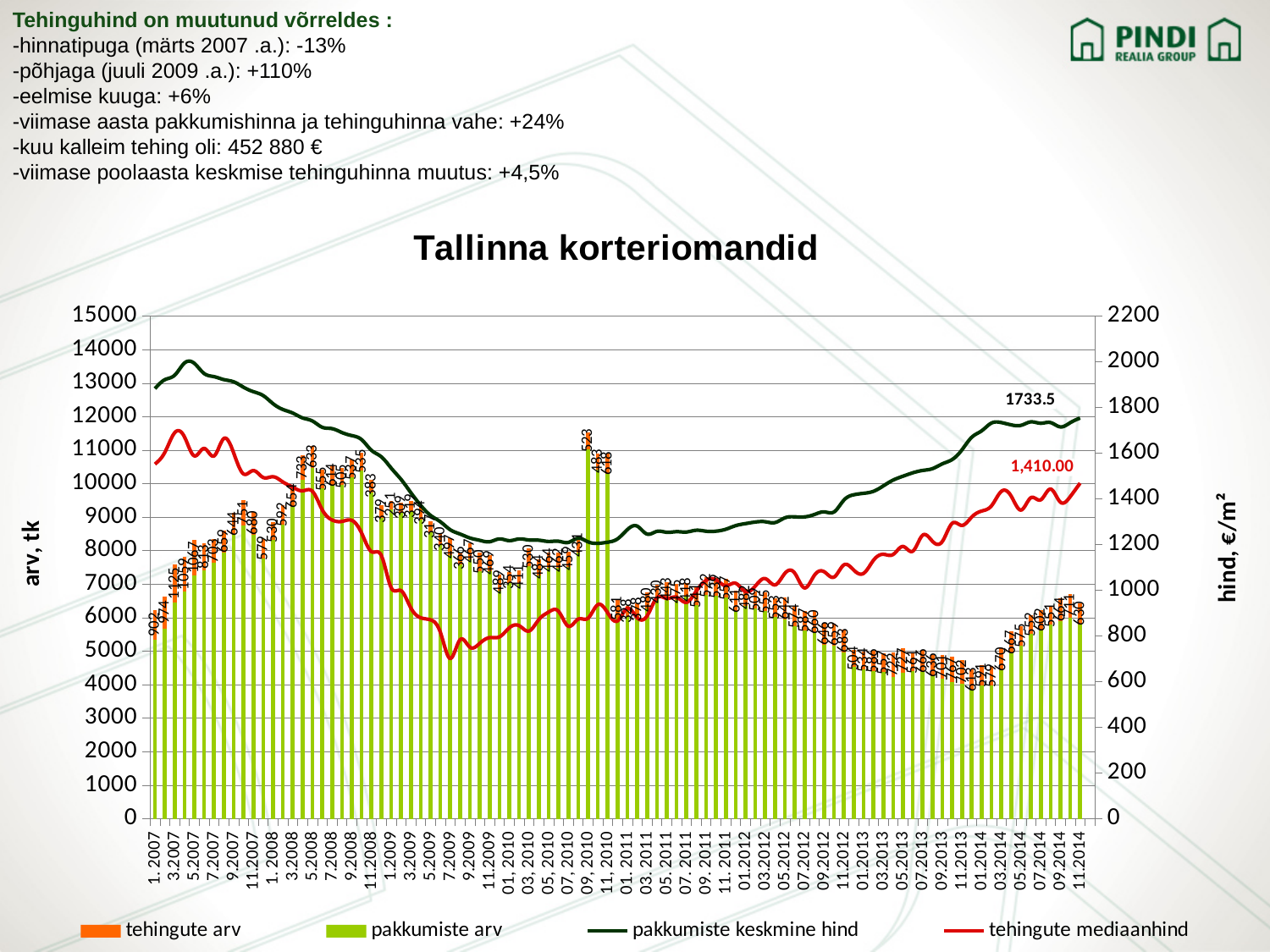
What is the labelled final value of the pakkumiste keskmine hind line? 1733.5 What is the title of the chart? Tallinna korteriomandid Does the pakkumiste keskmine hind line rise or fall between 1.2008 and 1.2010? fall In which month is the pakkumiste arv bar the highest? 09.2010 At the end of the chart, which is higher: pakkumiste keskmine hind or tehingute mediaanhind? pakkumiste keskmine hind What is the labelled final value of the tehingute mediaanhind line? 1,410.00 Is the tehingute mediaanhind value at 7.2009 greater or less than 800? less What is the difference between the labelled final values of pakkumiste keskmine hind (1733.5) and tehingute mediaanhind (1,410.00)? 323.5 Does the tehingute mediaanhind line rise or fall between 01.2012 and 11.2014? rise Is the pakkumiste keskmine hind value at 1.2007 greater or less than 1800? greater How many series does the chart legend list? 4 What kind of chart is shown on the slide? Combined bar and line chart